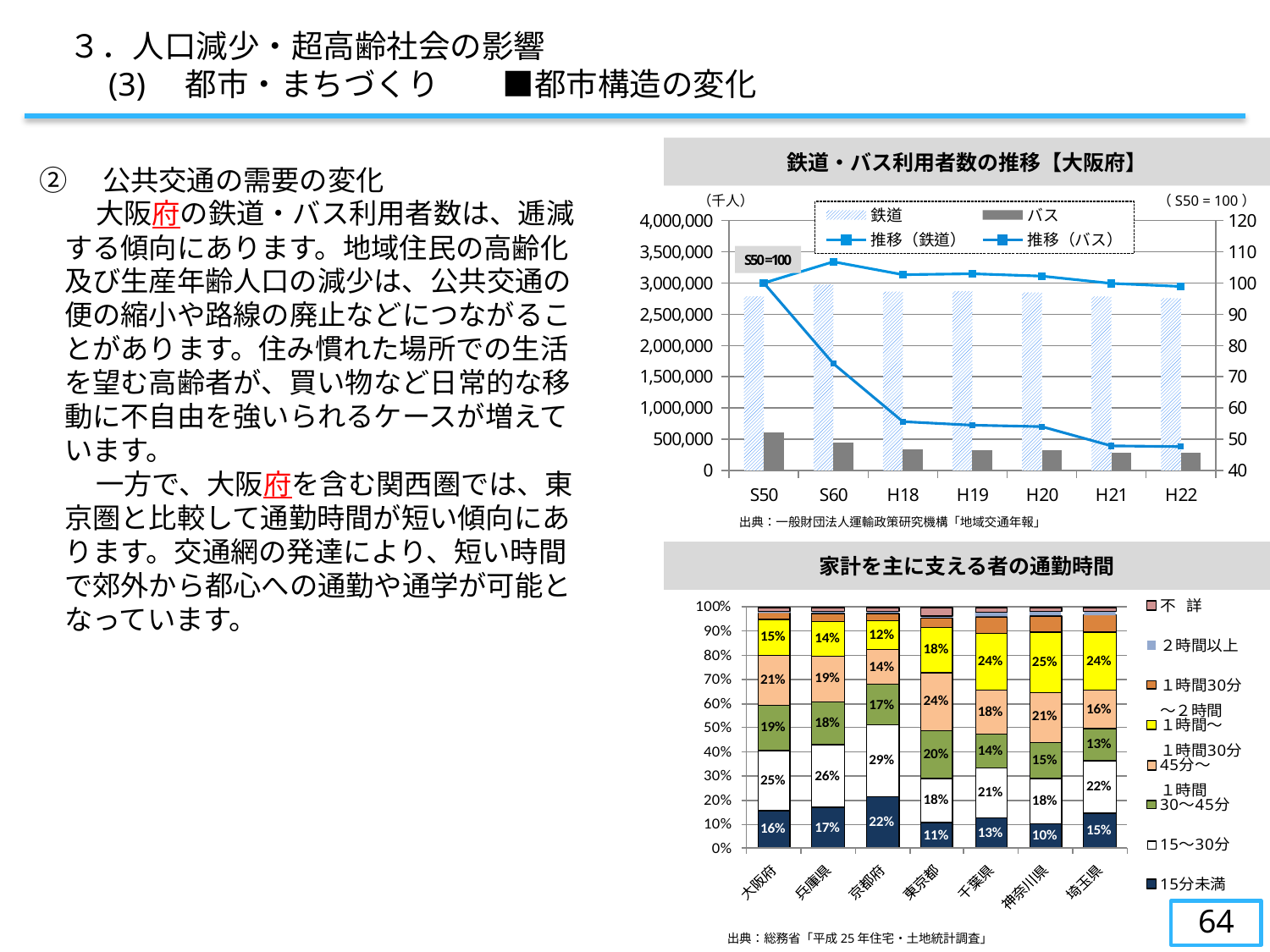
In the chart titled 鉄道・バス利用者数の推移【大阪府】, does the 推移（バス） line rise or fall from S50 to H22? fall In the chart titled 家計を主に支える者の通勤時間, what is the value for 1時間～1時間30分 for 神奈川県? 25% In the chart titled 鉄道・バス利用者数の推移【大阪府】, is the バス bar for S50 greater or less than 500,000? greater What kind of chart is the chart titled 家計を主に支える者の通勤時間? stacked bar chart In the chart titled 家計を主に支える者の通勤時間, what is the value for 15～30分 for 京都府? 29% In the chart titled 家計を主に支える者の通勤時間, which prefecture has the lowest value for 15分未満? 神奈川県 In the chart titled 家計を主に支える者の通勤時間, what is the value for 15分未満 for 大阪府? 16% In the chart titled 家計を主に支える者の通勤時間, which prefecture has the highest value for 15～30分? 京都府 In the chart titled 家計を主に支える者の通勤時間, which is larger: the 30～45分 value for 大阪府 or for 千葉県? 大阪府 In the chart titled 鉄道・バス利用者数の推移【大阪府】, how many series does the legend list? 4 In the chart titled 家計を主に支える者の通勤時間, how many prefectures are shown on the x axis? 7 In the chart titled 家計を主に支える者の通勤時間, what is the difference between the 45分～1時間 values for 東京都 and 京都府? 7%